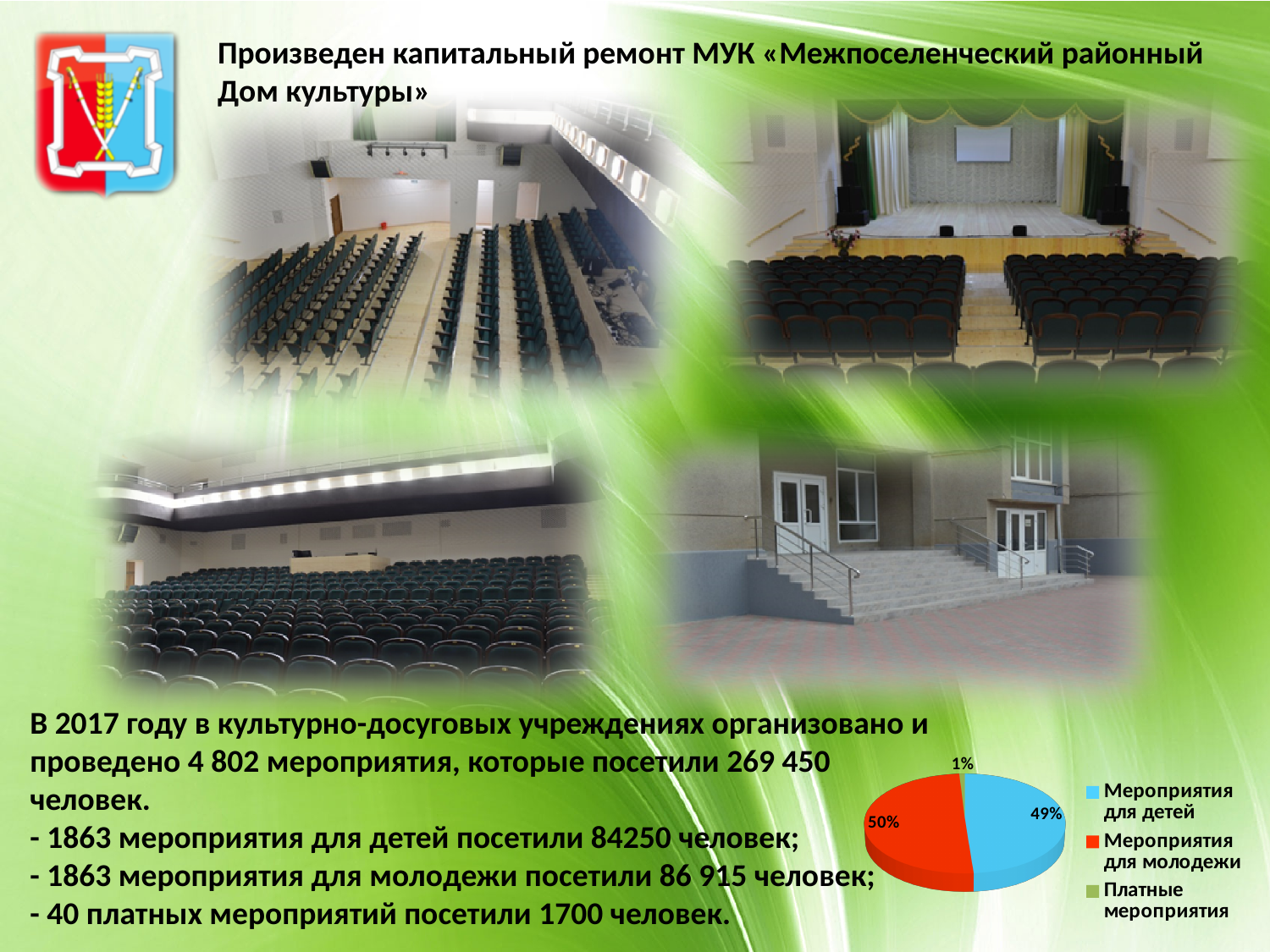
How many slices does the pie chart have? 3 What share of the pie chart is labelled "Мероприятия для детей"? 49% What colour is the "Мероприятия для молодежи" slice in the pie chart? red What is the difference in percentage points between the "Мероприятия для молодежи" slice and the "Мероприятия для детей" slice? 1% What share of the pie chart is labelled "Платные мероприятия"? 1% What colour is the "Мероприятия для детей" slice in the pie chart? blue Which slice is larger in the pie chart: "Мероприятия для детей" or "Платные мероприятия"? Мероприятия для детей Which category has the largest slice in the pie chart? Мероприятия для молодежи Which category has the smallest slice in the pie chart? Платные мероприятия What kind of chart is shown on the slide? pie chart How many entries does the legend of the pie chart list? 3 What share of the pie chart is labelled "Мероприятия для молодежи"? 50%